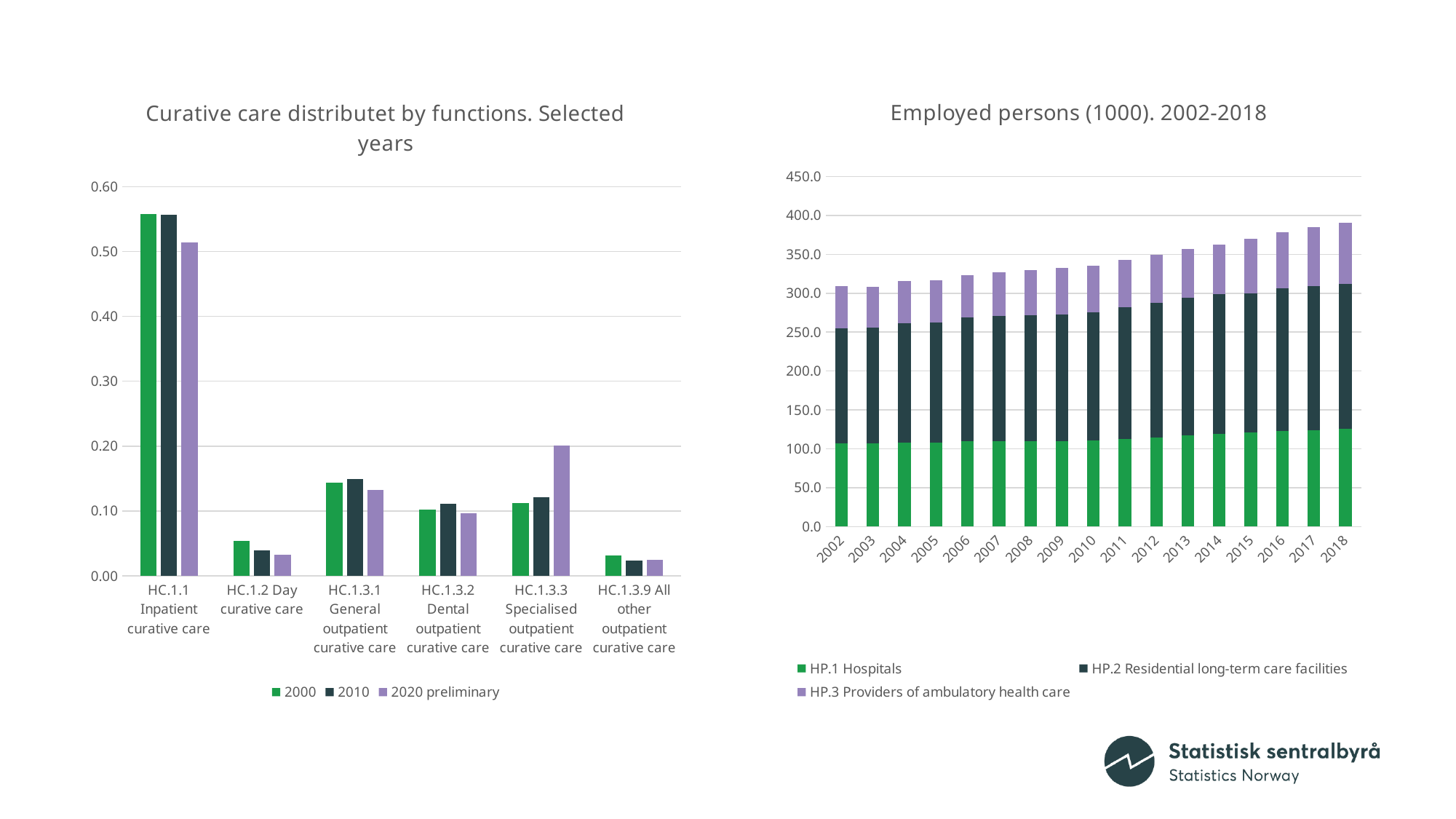
How many series does the legend of the left chart, 'Curative care distributet by functions. Selected years', list? 3 What type of chart is the left chart, 'Curative care distributet by functions. Selected years'? bar chart What type of chart is the right chart, 'Employed persons (1000). 2002-2018'? stacked bar chart In the right chart, 'Employed persons (1000). 2002-2018', do the total bar heights rise or fall from 2002 to 2018? rise How many categories are shown on the x axis of the left chart, 'Curative care distributet by functions. Selected years'? 6 In the left chart, 'Curative care distributet by functions. Selected years', which category has the highest value for 2000? HC.1.1 Inpatient curative care In the right chart, 'Employed persons (1000). 2002-2018', is the total for 2018 greater or less than 350.0? greater In the left chart, 'Curative care distributet by functions. Selected years', which is larger for HC.1.1 Inpatient curative care: the 2000 value or the 2020 preliminary value? 2000 In the left chart, 'Curative care distributet by functions. Selected years', which is larger for HC.1.3.3 Specialised outpatient curative care: the 2000 value or the 2020 preliminary value? 2020 preliminary In the left chart, 'Curative care distributet by functions. Selected years', is the 2000 value for HC.1.1 Inpatient curative care greater or less than 0.50? greater In the left chart, 'Curative care distributet by functions. Selected years', which category has the lowest value for 2000? HC.1.3.9 All other outpatient curative care How many years are shown on the x axis of the right chart, 'Employed persons (1000). 2002-2018'? 17